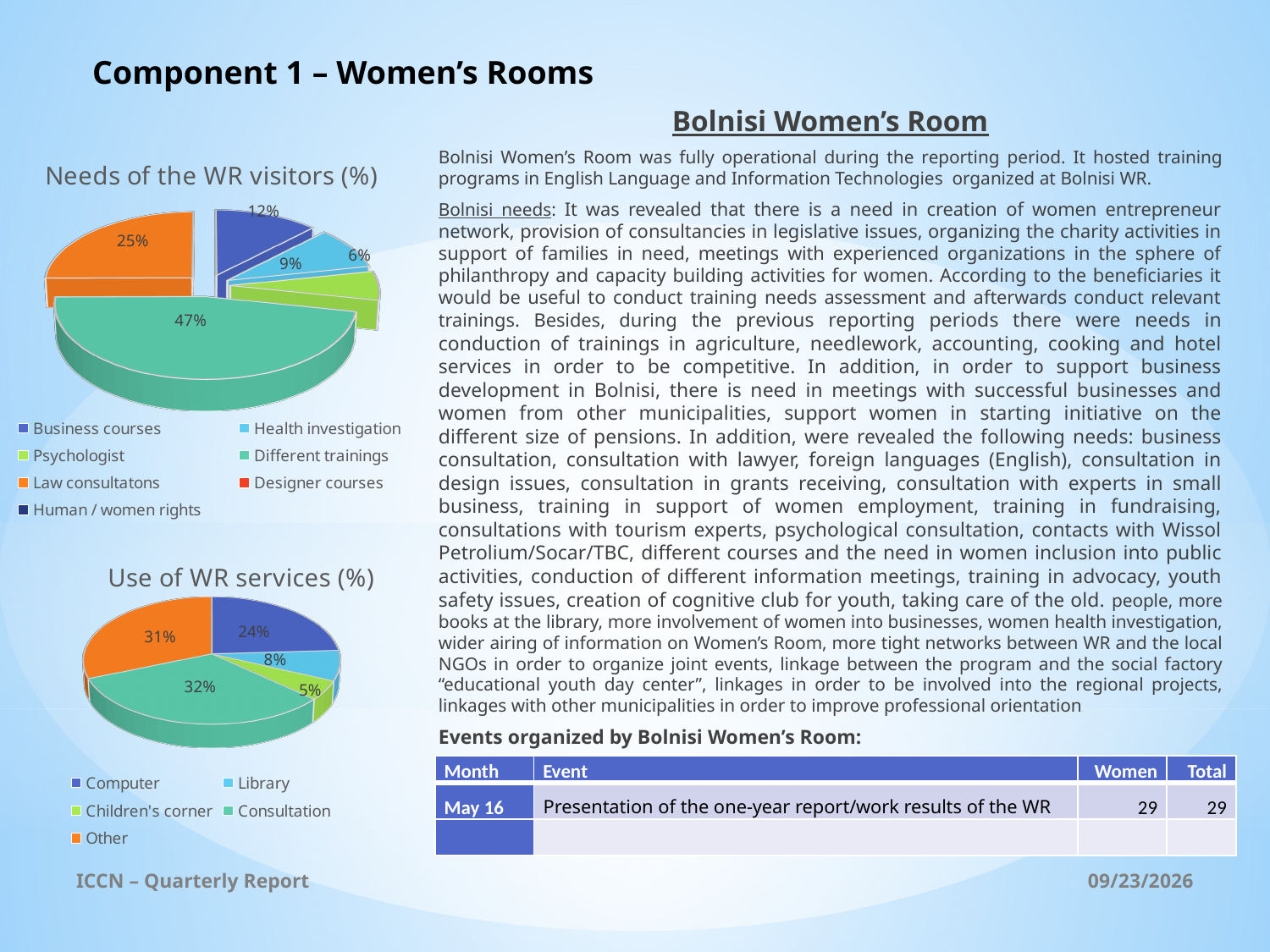
In the 'Use of WR services (%)' chart, which category has the smallest share? Children's corner In the 'Use of WR services (%)' chart, what percentage is shown for Consultation? 32% In the 'Needs of the WR visitors (%)' chart, what percentage is shown for Law consultatons? 25% In the 'Use of WR services (%)' chart, how many percentage points larger is Other than Library? 23 In the 'Needs of the WR visitors (%)' chart, what percentage is shown for Different trainings? 47% In the 'Use of WR services (%)' chart, what percentage is shown for Computer? 24% In the 'Needs of the WR visitors (%)' chart, what percentage is shown for Business courses? 12% What kind of chart is the 'Needs of the WR visitors (%)' chart? Pie chart In the 'Use of WR services (%)' chart, which is larger: Computer or Other? Other In the 'Needs of the WR visitors (%)' chart, which category has the largest share? Different trainings In the 'Needs of the WR visitors (%)' chart, how many percentage points larger is Different trainings than Law consultatons? 22 How many categories does the legend of the 'Needs of the WR visitors (%)' chart list? 7